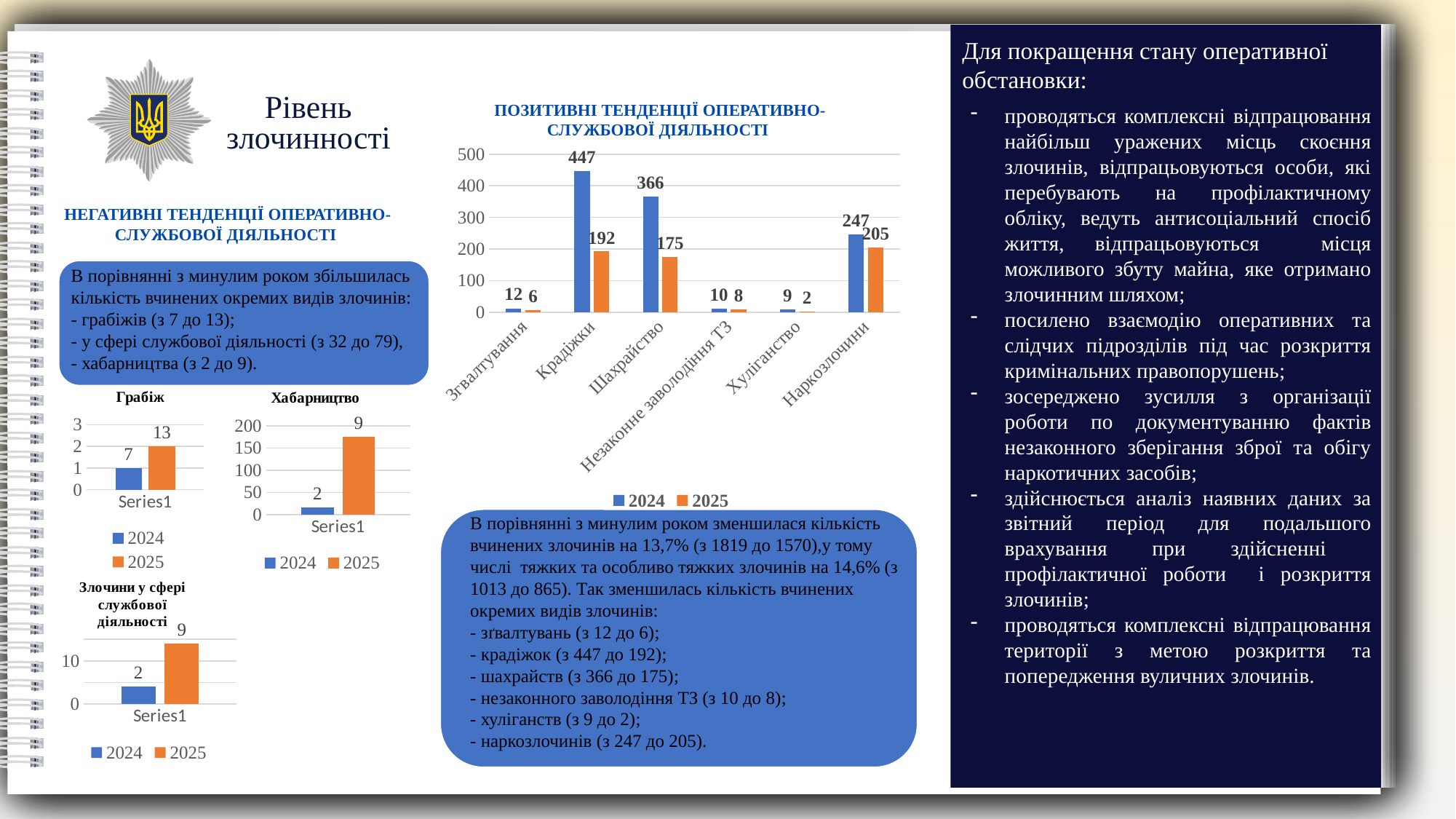
In the chart titled "ПОЗИТИВНІ ТЕНДЕНЦІЇ ОПЕРАТИВНО-СЛУЖБОВОЇ ДІЯЛЬНОСТІ", which category has the highest 2024 value? Крадіжки In the chart titled "ПОЗИТИВНІ ТЕНДЕНЦІЇ ОПЕРАТИВНО-СЛУЖБОВОЇ ДІЯЛЬНОСТІ", what is the difference between the 2024 and 2025 values for Наркозлочини? 42 In the small chart titled "Грабіж", what is the 2025 value? 13 What kind of chart is the one titled "ПОЗИТИВНІ ТЕНДЕНЦІЇ ОПЕРАТИВНО-СЛУЖБОВОЇ ДІЯЛЬНОСТІ"? Bar chart In the chart titled "ПОЗИТИВНІ ТЕНДЕНЦІЇ ОПЕРАТИВНО-СЛУЖБОВОЇ ДІЯЛЬНОСТІ", which category has the lowest 2025 value? Хуліганство In the chart titled "ПОЗИТИВНІ ТЕНДЕНЦІЇ ОПЕРАТИВНО-СЛУЖБОВОЇ ДІЯЛЬНОСТІ", which is larger: the 2025 value for Крадіжки or the 2025 value for Наркозлочини? Наркозлочини In the small chart titled "Злочини у сфері службової діяльності", what is the difference between the 2025 and 2024 values? 7 In the small chart titled "Хабарництво", what is the 2024 value? 2 In the chart titled "ПОЗИТИВНІ ТЕНДЕНЦІЇ ОПЕРАТИВНО-СЛУЖБОВОЇ ДІЯЛЬНОСТІ", what is the 2025 value for Шахрайство? 175 In the chart titled "ПОЗИТИВНІ ТЕНДЕНЦІЇ ОПЕРАТИВНО-СЛУЖБОВОЇ ДІЯЛЬНОСТІ", how many series does the legend list? 2 In the chart titled "ПОЗИТИВНІ ТЕНДЕНЦІЇ ОПЕРАТИВНО-СЛУЖБОВОЇ ДІЯЛЬНОСТІ", what is the 2024 value for Крадіжки? 447 In the chart titled "ПОЗИТИВНІ ТЕНДЕНЦІЇ ОПЕРАТИВНО-СЛУЖБОВОЇ ДІЯЛЬНОСТІ", how many categories are shown on the x axis? 6